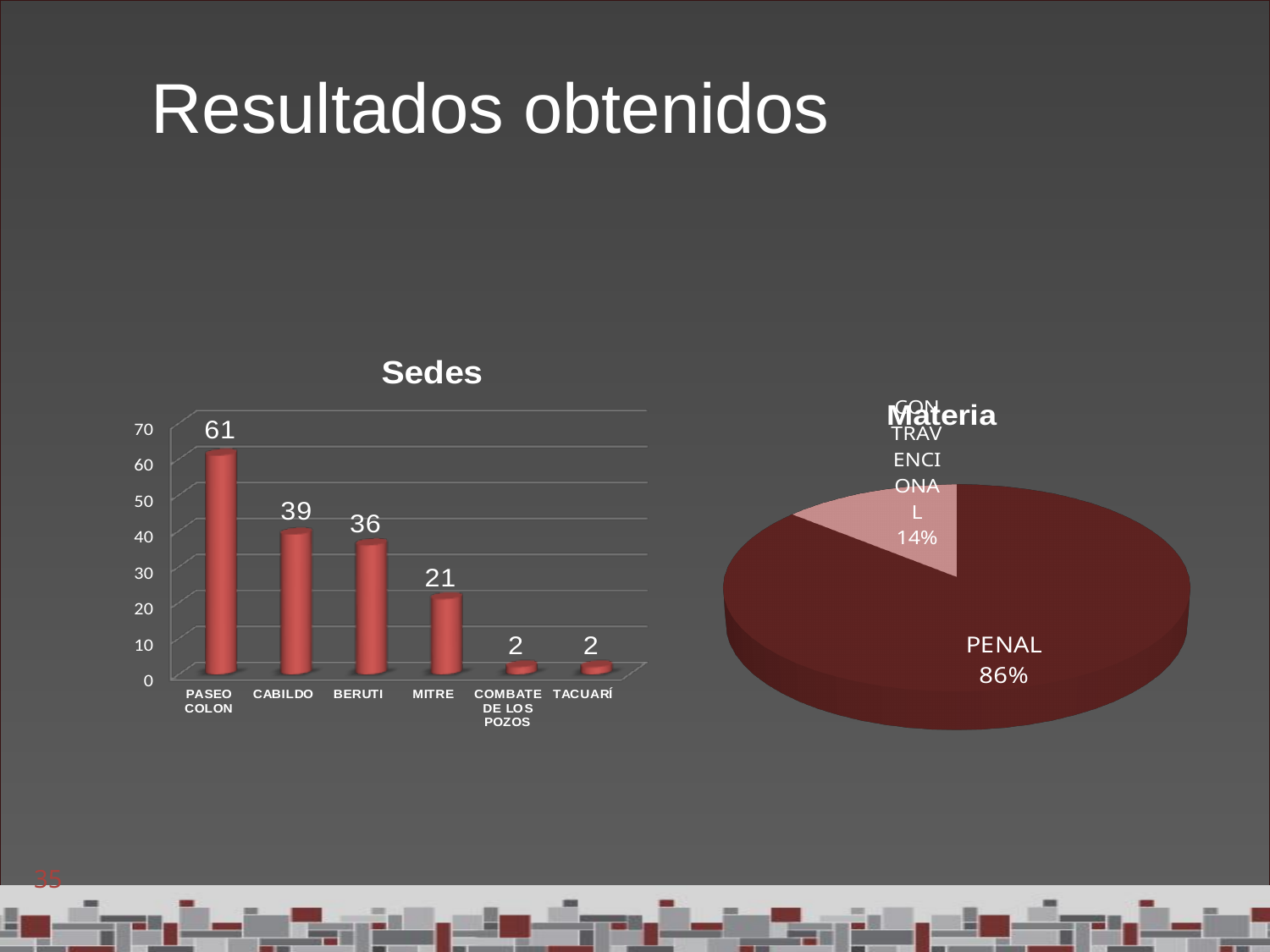
In the 'Sedes' chart, which category has the highest value? PASEO COLON What kind of chart is the 'Sedes' chart? Bar chart In the 'Sedes' chart, what is the difference between the values for PASEO COLON and CABILDO? 22 In the 'Sedes' chart, how many categories are shown on the x axis? 6 In the 'Sedes' chart, which is larger, the value for CABILDO or the value for BERUTI? CABILDO What kind of chart is the 'Materia' chart? Pie chart In the 'Sedes' chart, what is the value for MITRE? 21 In the 'Sedes' chart, do the values rise or fall from left to right along the x axis? Fall In the 'Sedes' chart, what is the value for PASEO COLON? 61 In the 'Materia' pie chart, what share does PENAL have? 86% In the 'Sedes' chart, what is the value for BERUTI? 36 In the 'Materia' pie chart, what share does CONTRAVENCIONAL have? 14%